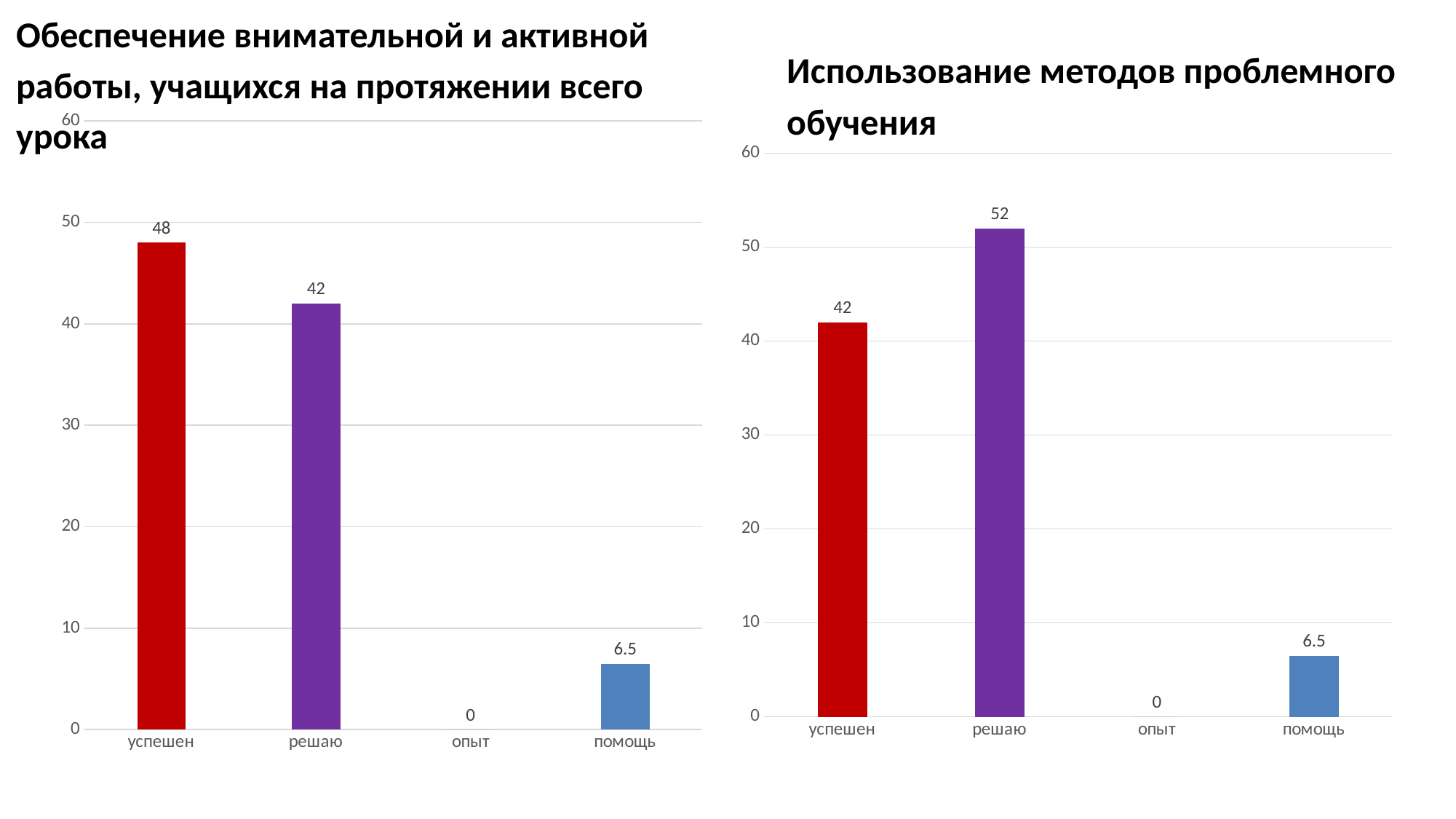
In the left chart, which category has the lowest value? опыт In the left chart (Обеспечение внимательной и активной работы...), what is the value for успешен? 48 In the right chart, what is the difference between the values for решаю and успешен? 10 How many categories are shown on the x axis of the left chart? 4 In the right chart (Использование методов проблемного обучения), what is the value for решаю? 52 In the right chart, what is the value for опыт? 0 In the left chart, what is the difference between the values for успешен and решаю? 6 In the right chart, which category has the highest value? решаю In the left chart, which category has the highest value? успешен What kind of chart is the right chart (Использование методов проблемного обучения)? Bar chart In the right chart, which is larger, the value for успешен or the value for помощь? успешен In the left chart, what is the value for помощь? 6.5